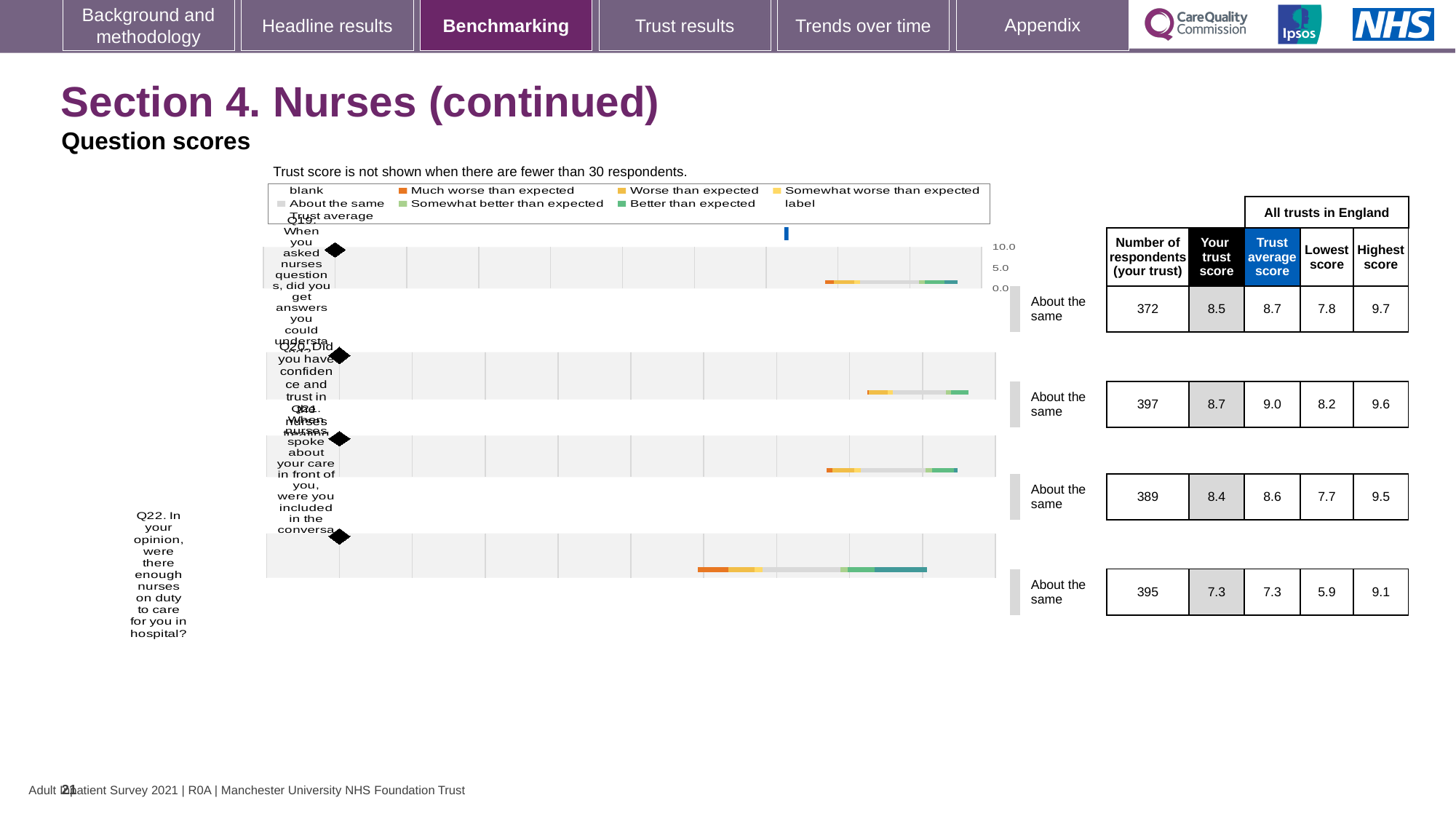
Which legend entry is shown in orange? Much worse than expected How many questions (Q19 to Q22) are plotted in the chart? 4 What kind of chart is used to show the question scores on this slide? bar chart Which question has the highest 'Your trust score'? Q20 Which question has the lowest 'Your trust score'? Q22 What is the lowest score across all trusts in England for Q22? 5.9 For Q21, which is larger: your trust score or the trust average score? Trust average score For Q20, how much higher is the trust average score than your trust score? 0.3 For Q19, what is the difference between the highest score and the lowest score across all trusts in England? 1.9 What is the 'Your trust score' for Q22 (were there enough nurses on duty)? 7.3 How many respondents from your trust answered Q20 (confidence and trust in the nurses)? 397 What benchmark category label is shown next to each of the four questions? About the same